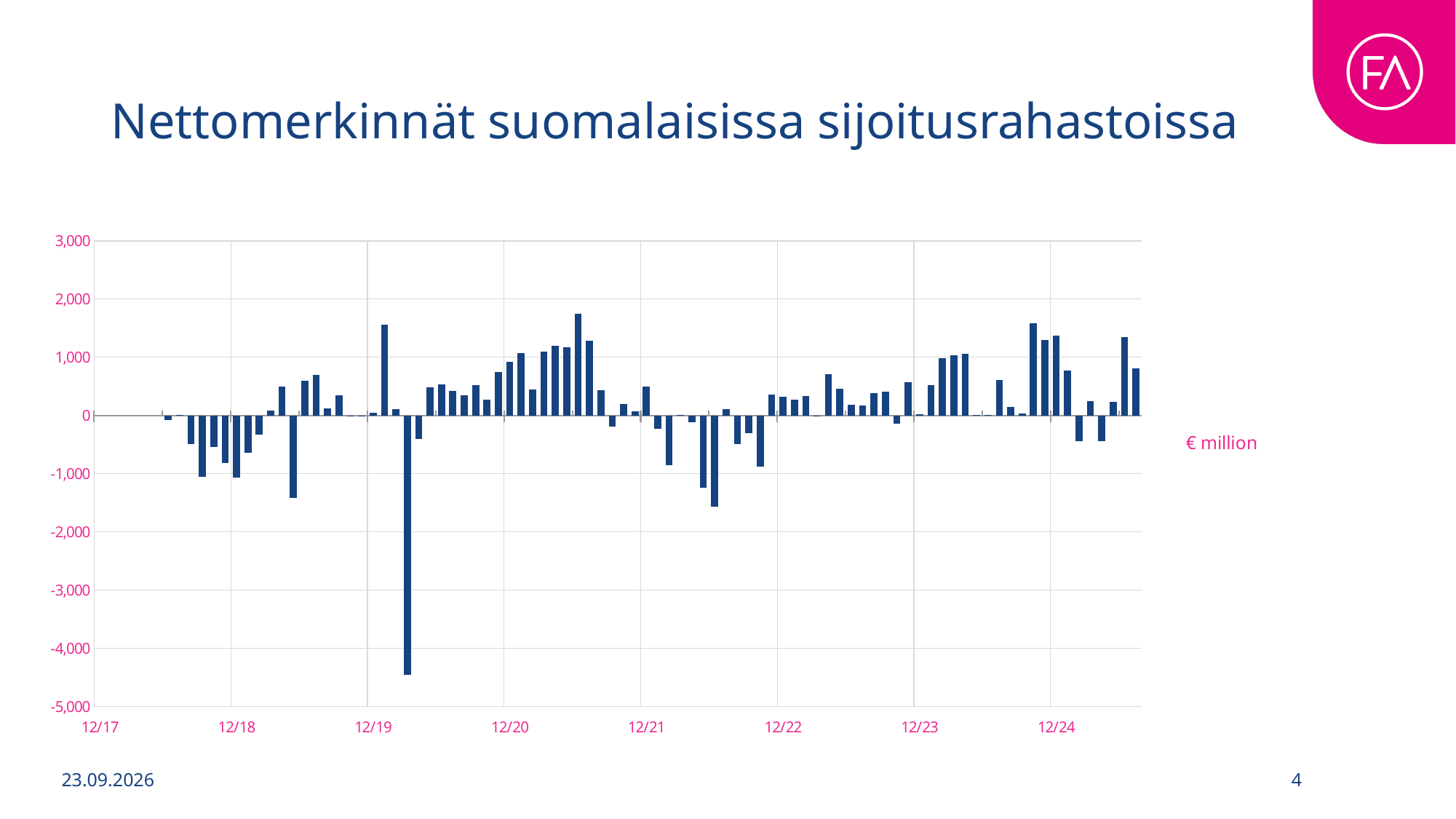
What is the highest value shown on the y axis? 3,000 Which is larger, the lowest value shortly after 12/19 or the lowest value shortly after 12/21? the lowest value shortly after 12/21 Is the lowest value on the chart greater or less than -4,000? less What is the title of the chart on the slide? Nettomerkinnät suomalaisissa sijoitusrahastoissa What kind of chart is shown on the slide? bar chart Is the highest value on the chart greater or less than 2,000? less What unit is indicated next to the chart? € million Is the value for the bar at 12/22 greater or less than 1,000? less How many date labels are shown on the x axis? 8